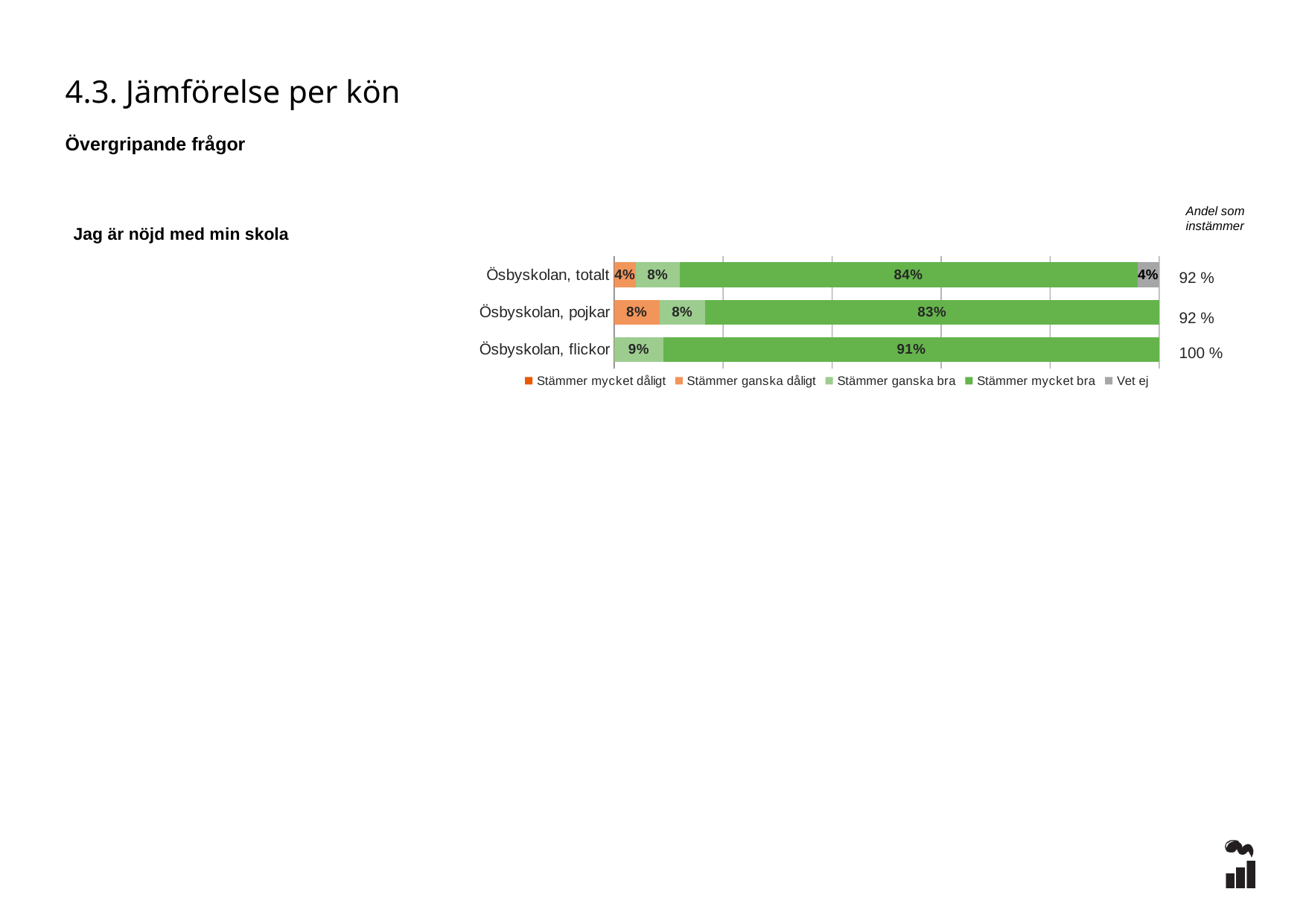
How many series does the legend list? 5 What is the difference between the 'Stämmer mycket bra' values for Ösbyskolan, flickor and Ösbyskolan, pojkar? 8% What kind of chart is shown on the slide? Stacked bar chart What is the 'Stämmer ganska dåligt' value for Ösbyskolan, pojkar? 8% What is the 'Stämmer mycket bra' value for Ösbyskolan, pojkar? 83% What is the 'Vet ej' value for Ösbyskolan, totalt? 4% What is the 'Andel som instämmer' value shown for Ösbyskolan, flickor? 100 % Which category has the highest 'Stämmer mycket bra' value? Ösbyskolan, flickor What is the 'Stämmer ganska bra' value for Ösbyskolan, flickor? 9% What is the question statement shown as the chart's title? Jag är nöjd med min skola What is the 'Stämmer mycket bra' value for Ösbyskolan, totalt? 84% How many categories (bars) does the chart show? 3